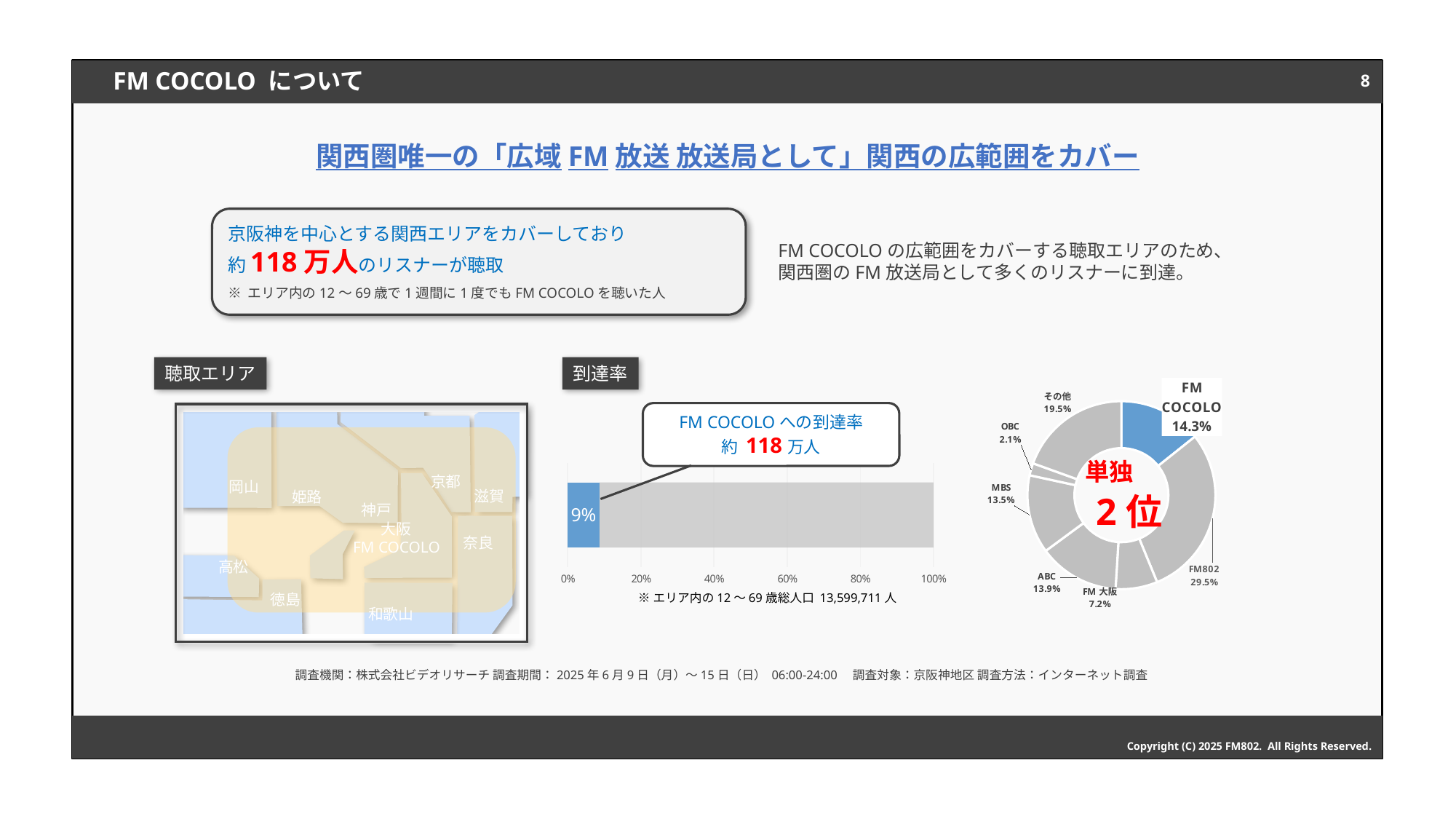
In the 到達率 bar chart, what is the maximum value shown on the x axis? 100% In the 到達率 bar chart, what value is shown on the bar? 9% In the donut chart on the right, what is the value for FM802? 29.5% In the donut chart on the right, what is the value for FM COCOLO? 14.3% In the donut chart on the right, what is the difference between FM802 and FM COCOLO? 15.2% What kind of chart is the 到達率 chart in the middle of the slide? Bar chart In the donut chart on the right, which station has the smallest share? OBC In the donut chart on the right, which station has the largest share? FM802 How many segments does the donut chart on the right have? 7 In the donut chart on the right, what is the value for OBC? 2.1% In the donut chart on the right, what is the value for その他? 19.5% In the donut chart on the right, which is larger, ABC or FM 大阪? ABC